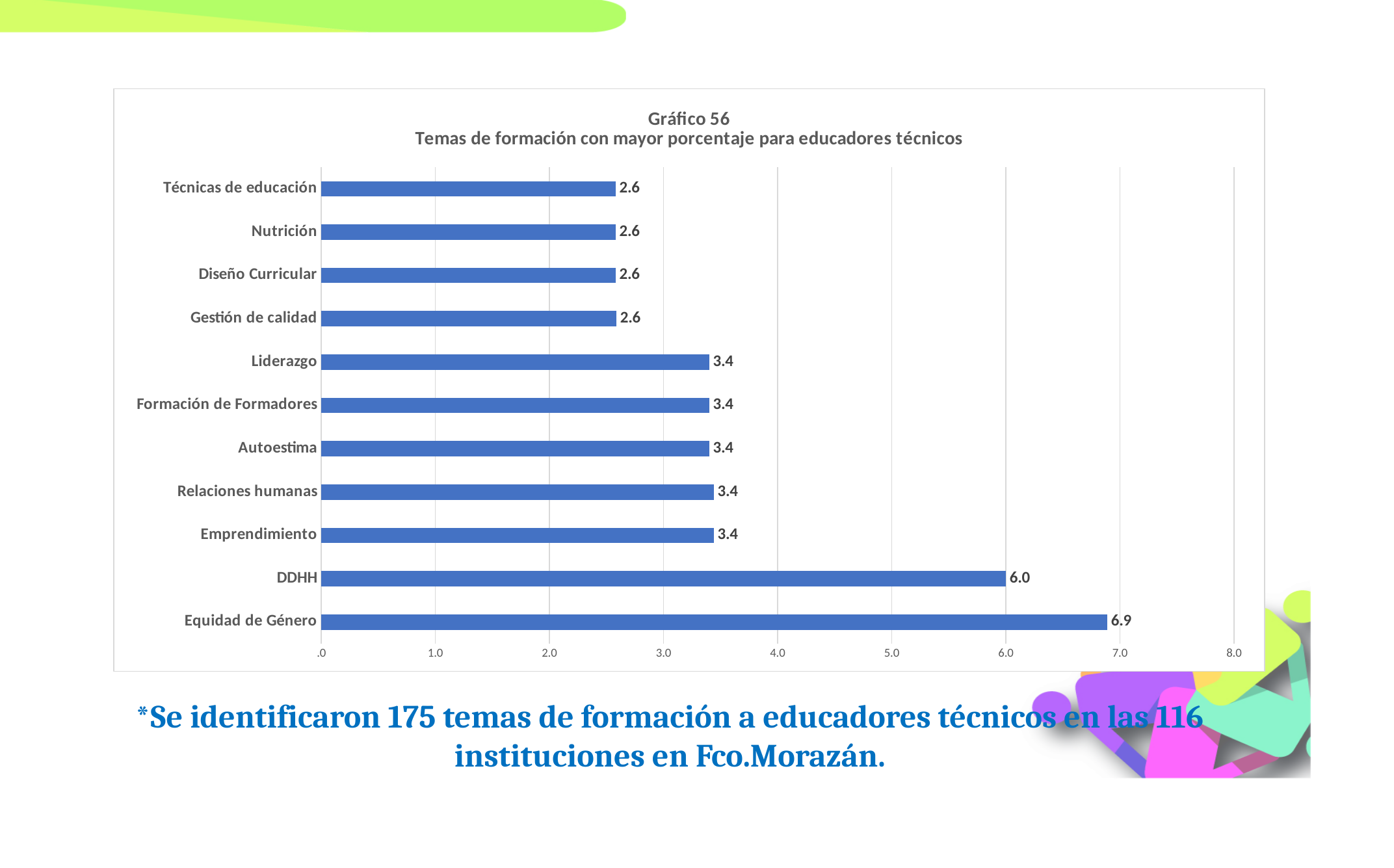
How many categories are shown in the chart? 11 What is the title of the chart? Gráfico 56 Temas de formación con mayor porcentaje para educadores técnicos What kind of chart is shown on the slide? Bar chart What is the value for DDHH? 6.0 What is the value for Equidad de Género? 6.9 What is the value for Nutrición? 2.6 What is the value for Liderazgo? 3.4 What is the difference between the values for Equidad de Género and DDHH? 0.9 Which category has the highest value? Equidad de Género What is the difference between the values for Emprendimiento and Gestión de calidad? 0.8 Is the value for DDHH greater or less than 5.0? greater Which is larger, the value for DDHH or the value for Autoestima? DDHH